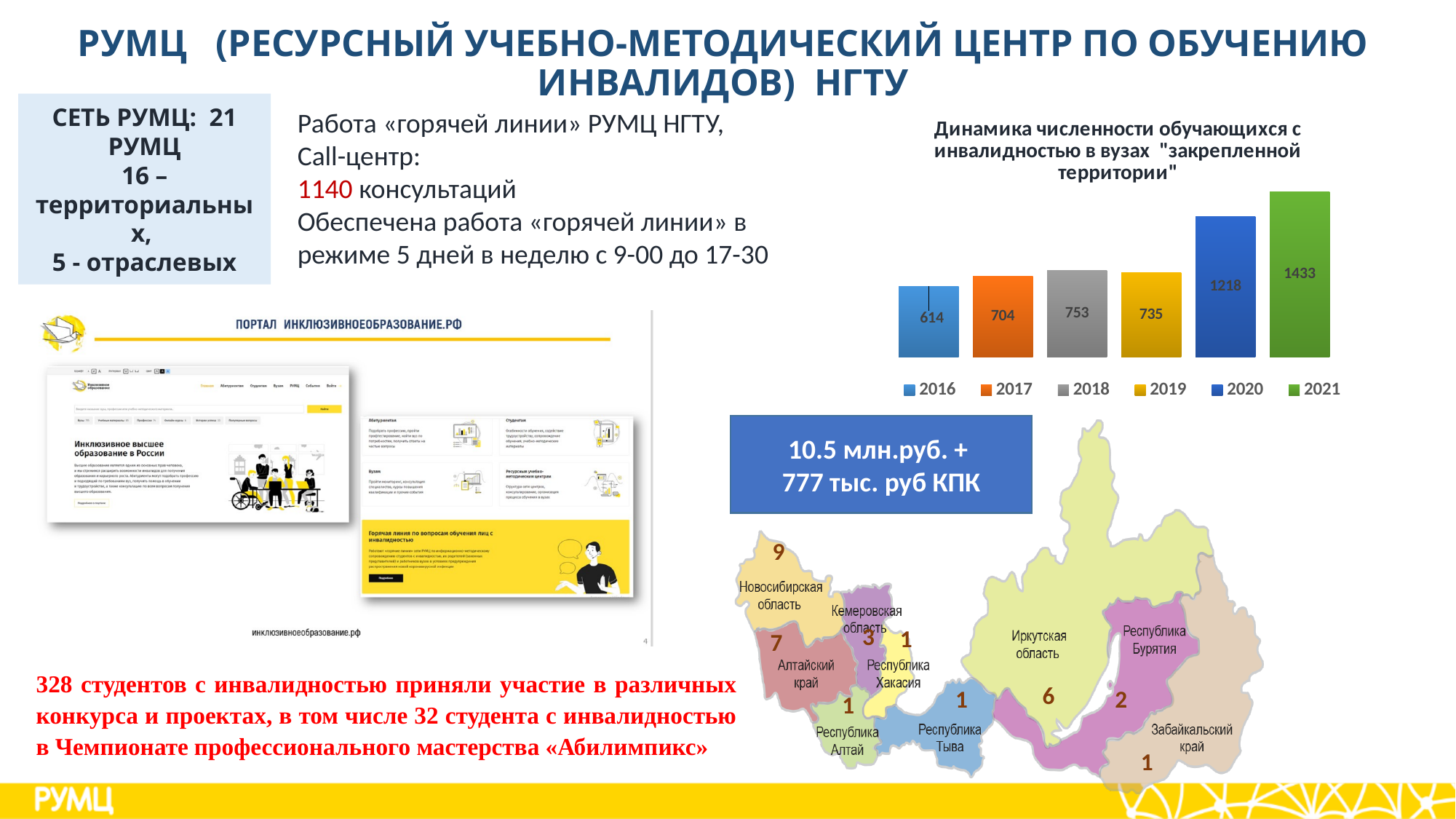
What kind of chart is shown on the slide? bar chart Which year has the highest value in the bar chart? 2021 How many bars are shown in the bar chart? 6 Which year has the lowest value in the bar chart? 2016 What is the value for 2018 in the bar chart? 753 What is the difference between the values for 2017 and 2016 in the bar chart? 90 Which is larger in the bar chart, the value for 2018 or the value for 2019? 2018 What is the value for 2016 in the bar chart? 614 How many entries does the legend of the bar chart list? 6 What is the difference between the values for 2021 and 2020 in the bar chart? 215 What is the title of the bar chart? Динамика численности обучающихся с инвалидностью в вузах "закрепленной территории" What is the value for 2020 in the bar chart? 1218